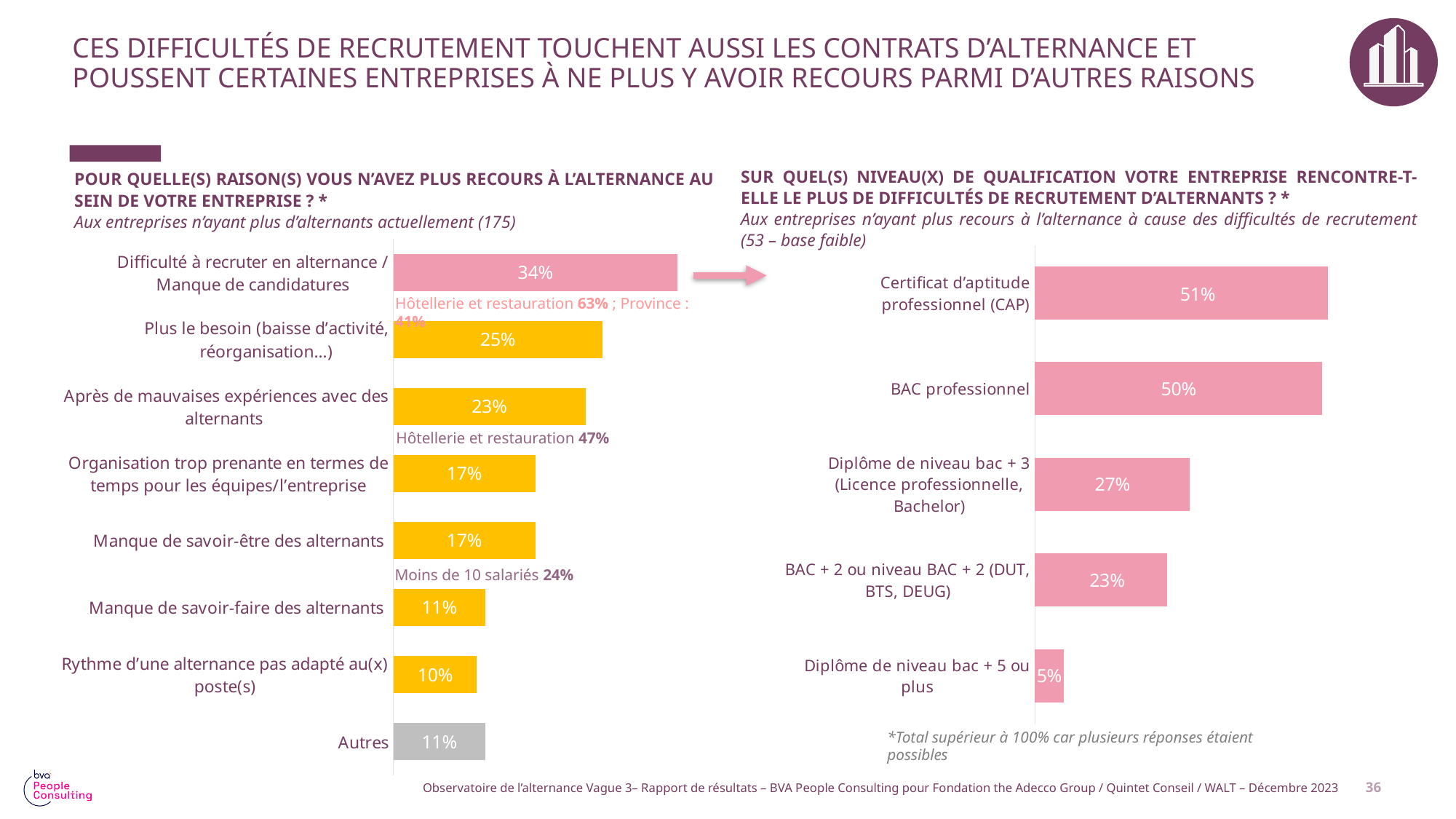
In the right chart on qualification levels with recruitment difficulties, what is the value for "BAC professionnel"? 50% In the left chart on reasons for no longer using apprenticeships, which is larger: "Manque de savoir-être des alternants" or "Manque de savoir-faire des alternants"? Manque de savoir-être des alternants In the left chart on reasons for no longer using apprenticeships, which reason has the highest value? Difficulté à recruter en alternance / Manque de candidatures In the left chart on reasons for no longer using apprenticeships, what is the difference between "Difficulté à recruter en alternance / Manque de candidatures" and "Après de mauvaises expériences avec des alternants"? 11 percentage points In the left chart on reasons for no longer using apprenticeships, what is the value for "Plus le besoin (baisse d'activité, réorganisation…)"? 25% In the right chart on qualification levels with recruitment difficulties, how many qualification levels are shown? 5 In the right chart on qualification levels with recruitment difficulties, what is the difference between "Certificat d'aptitude professionnel (CAP)" and "BAC + 2 ou niveau BAC + 2 (DUT, BTS, DEUG)"? 28 percentage points In the right chart on qualification levels with recruitment difficulties, which level has the lowest value? Diplôme de niveau bac + 5 ou plus In the right chart on qualification levels with recruitment difficulties, what is the value for "Diplôme de niveau bac + 3 (Licence professionnelle, Bachelor)"? 27% What type of chart is the right chart on qualification levels with recruitment difficulties? Bar chart In the left chart on reasons for no longer using apprenticeships, what is the value for "Rythme d'une alternance pas adapté au(x) poste(s)"? 10% In the left chart on reasons for no longer using apprenticeships, how many reasons are listed? 8